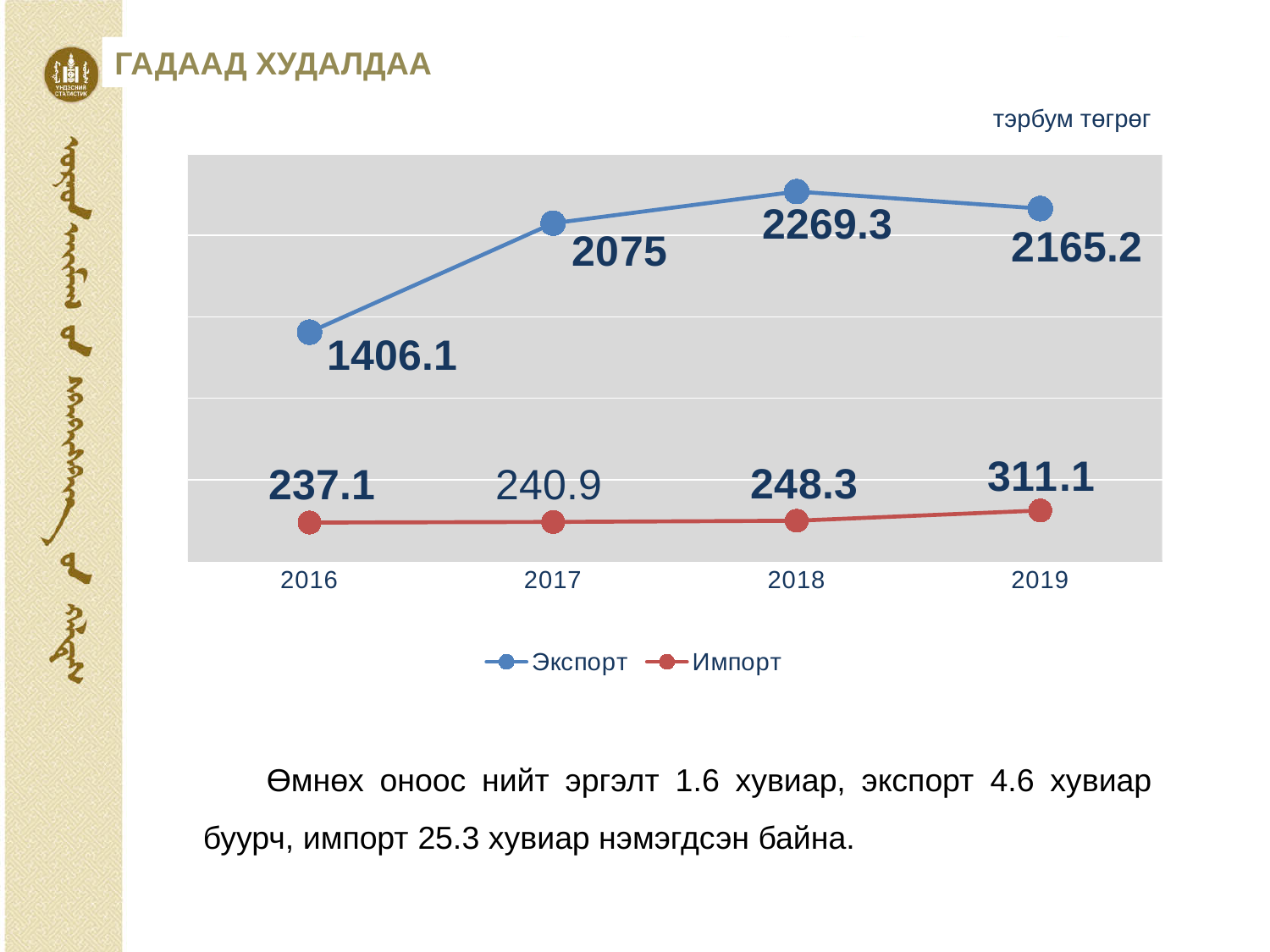
What is the value for Экспорт in 2018? 2269.3 What is the value for Импорт in 2019? 311.1 Does Импорт rise or fall from 2016 to 2019? Rise In which year is Импорт lowest? 2016 What kind of chart is shown on the slide? Line chart What is the value for Импорт in 2017? 240.9 How many years are shown on the x axis? 4 What is the difference between Экспорт in 2018 and Экспорт in 2019? 104.1 How many series does the legend list? 2 What is the value for Экспорт in 2016? 1406.1 Which is larger: Экспорт in 2017 or Экспорт in 2019? Экспорт in 2019 In which year is Экспорт highest? 2018